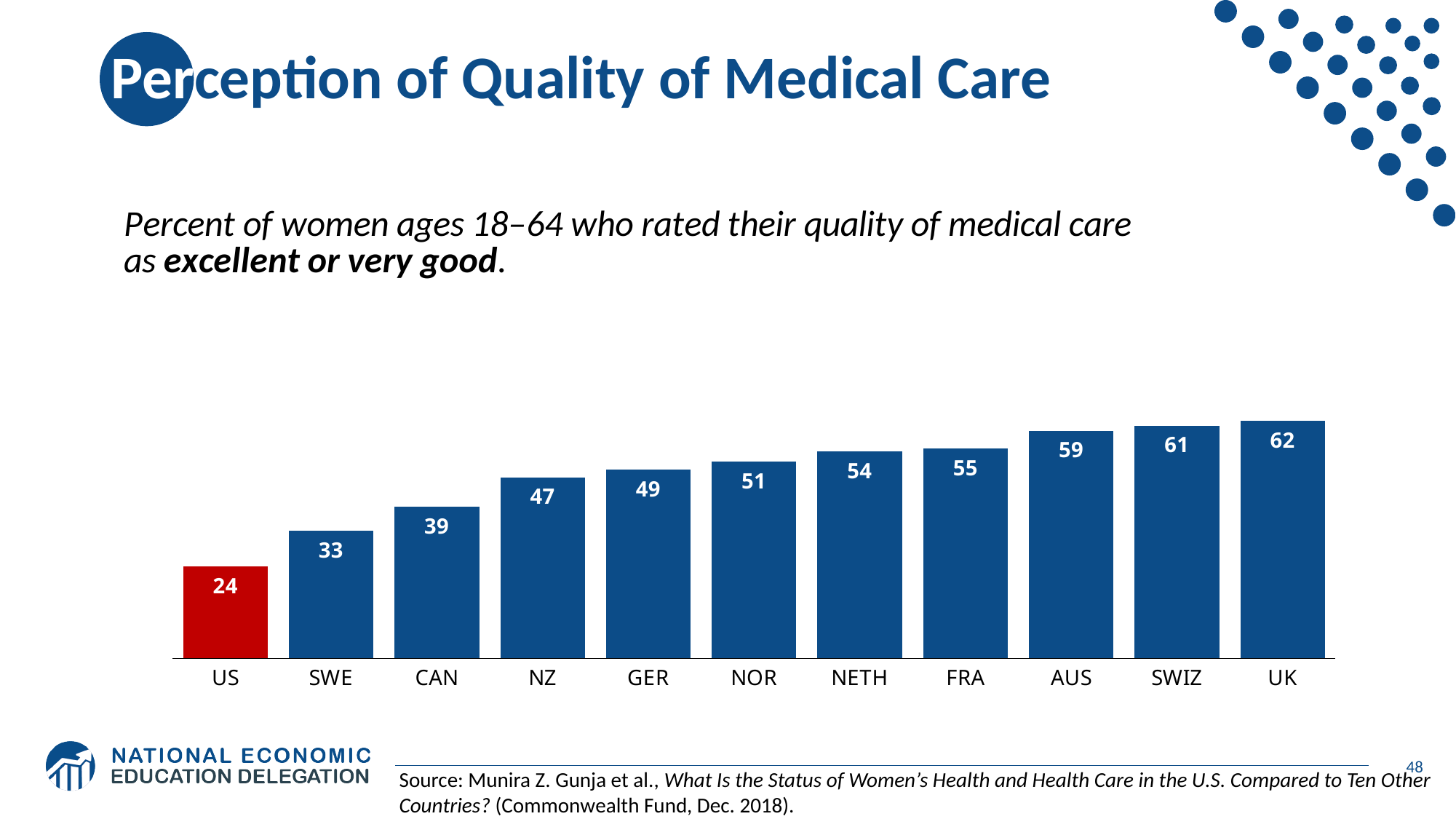
Which country has the highest value? UK What is the difference between the values for NETH and CAN? 15 What is the value for AUS? 59 How many countries are shown in the chart? 11 Which country has the lowest value? US What kind of chart is shown on the slide? Bar chart What is the difference between the values for UK and US? 38 Do the values rise or fall from left to right along the x axis? Rise Which bar is coloured red rather than blue? US What is the value for the US? 24 Which has a larger value, SWE or NZ? NZ What is the value for GER? 49